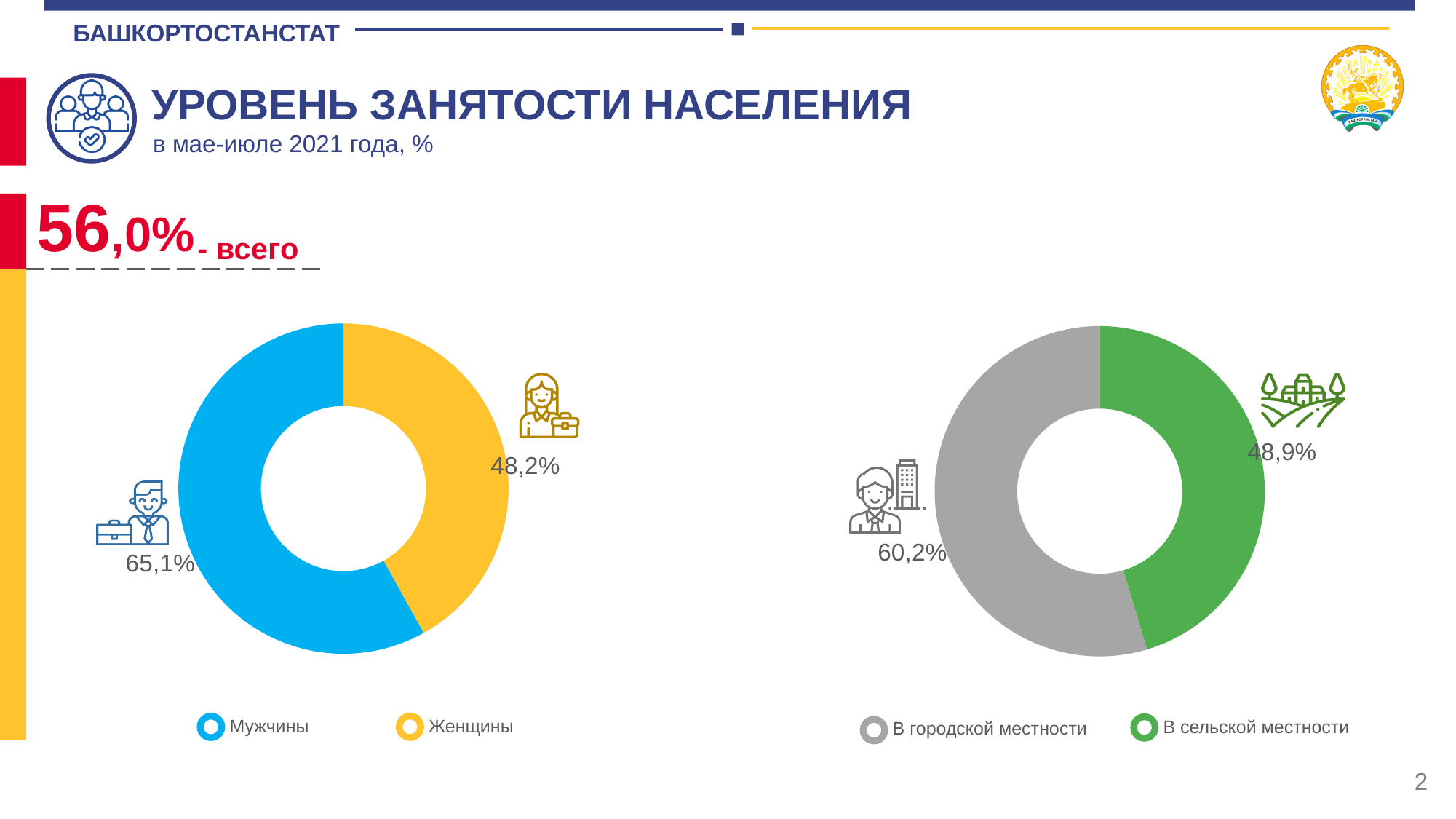
On the left chart, which colour represents Женщины? Yellow On the right chart, what is the value for В сельской местности? 48,9% On the left chart, what is the difference between the values for Мужчины and Женщины? 16,9 On the left chart, what is the value for Женщины? 48,2% On the right chart, what is the value for В городской местности? 60,2% How many categories does the right chart's legend list? 2 On the right chart, which category has the lower value? В сельской местности What overall value (всего) is shown on the slide? 56,0% On the right chart, what is the difference between the values for В городской местности and В сельской местности? 11,3 What kind of chart is the left chart? Doughnut chart On the left chart, what is the value for Мужчины? 65,1% On the left chart, which category has the higher value, Мужчины or Женщины? Мужчины